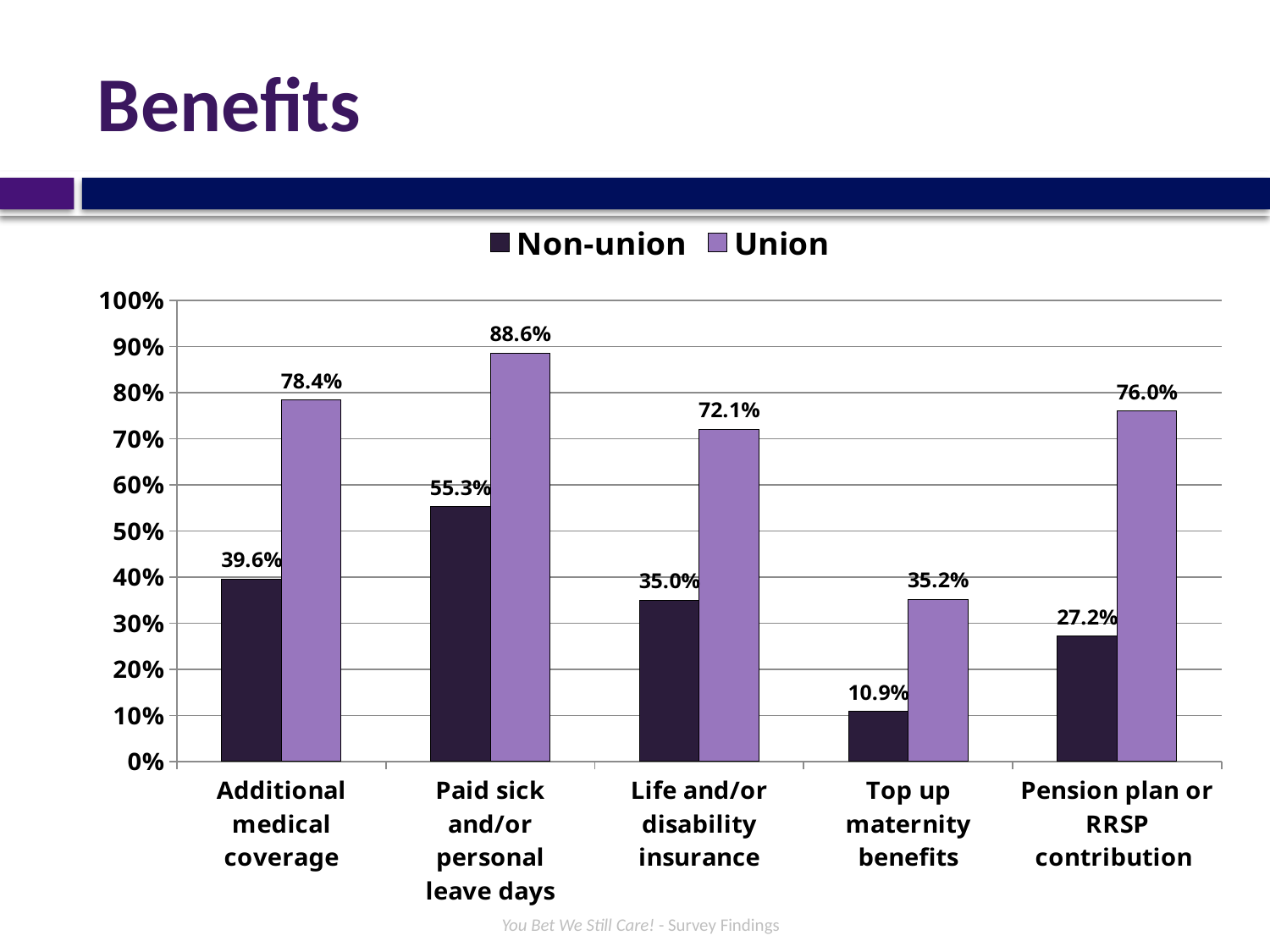
What is the Non-union value for Pension plan or RRSP contribution? 27.2% Is the Union value for Pension plan or RRSP contribution greater or less than 70%? greater Which category has the highest Union value? Paid sick and/or personal leave days What is the Union value for Paid sick and/or personal leave days? 88.6% What is the difference between the Union and Non-union values for Additional medical coverage? 38.8% What kind of chart is shown on the slide? Bar chart What is the Non-union value for Top up maternity benefits? 10.9% What are the two series named in the legend? Non-union and Union Which category has the lowest Non-union value? Top up maternity benefits How many benefit categories are shown on the x axis? 5 Which is larger for Life and/or disability insurance, the Union value or the Non-union value? Union How many series does the legend list? 2